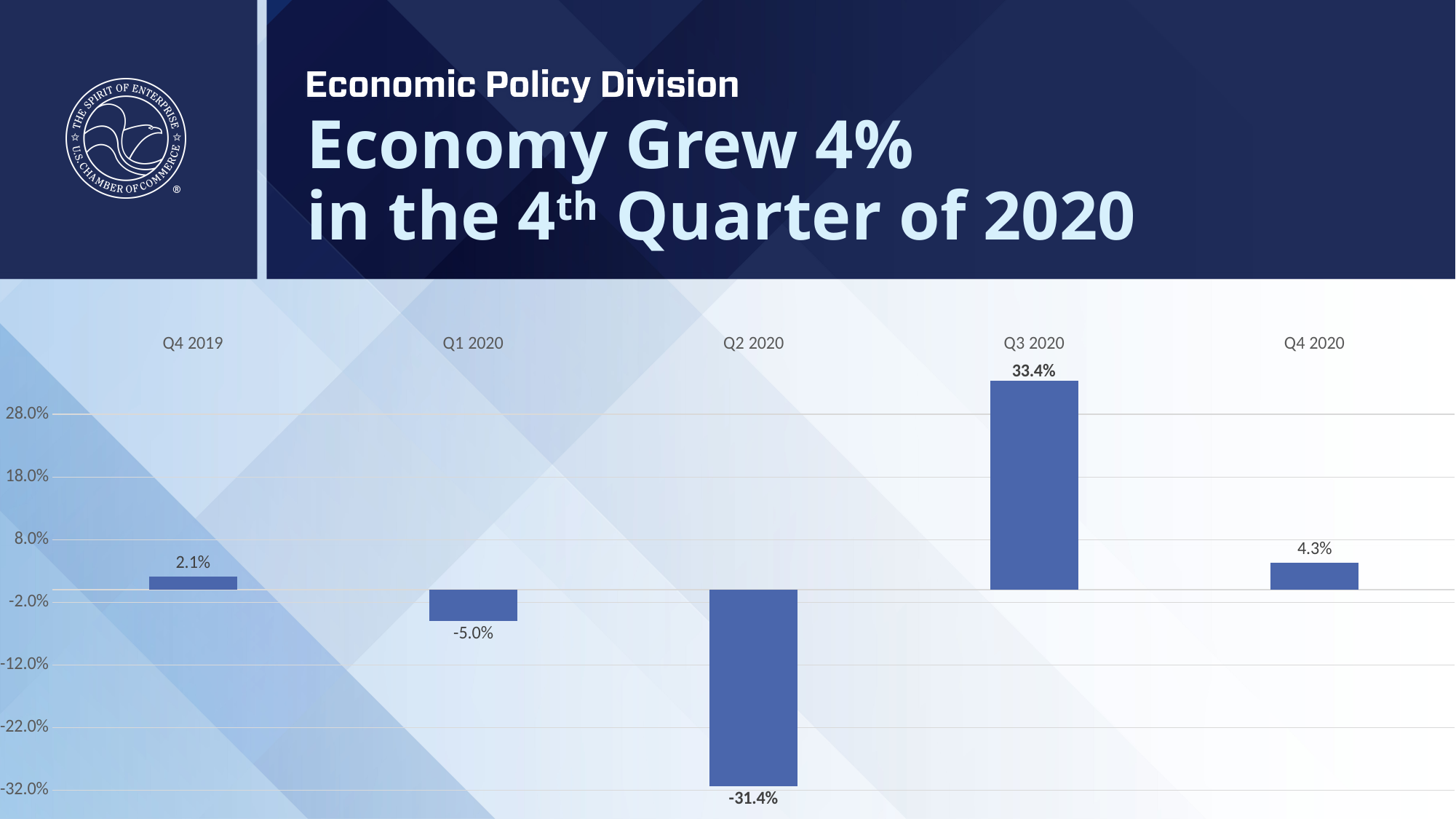
Which quarter has the highest value? Q3 2020 How many quarters are shown in the chart? 5 Which is larger, the value for Q4 2020 or the value for Q4 2019? Q4 2020 What kind of chart is shown on the slide? Bar chart What is the value for Q4 2020? 4.3% What is the difference between the values for Q4 2020 and Q4 2019? 2.2% Is the value for Q3 2020 greater or less than 28.0%? greater What is the value for Q2 2020? -31.4% What is the value for Q4 2019? 2.1% What is the value for Q3 2020? 33.4% What is the value for Q1 2020? -5.0% Which quarter has the lowest value? Q2 2020